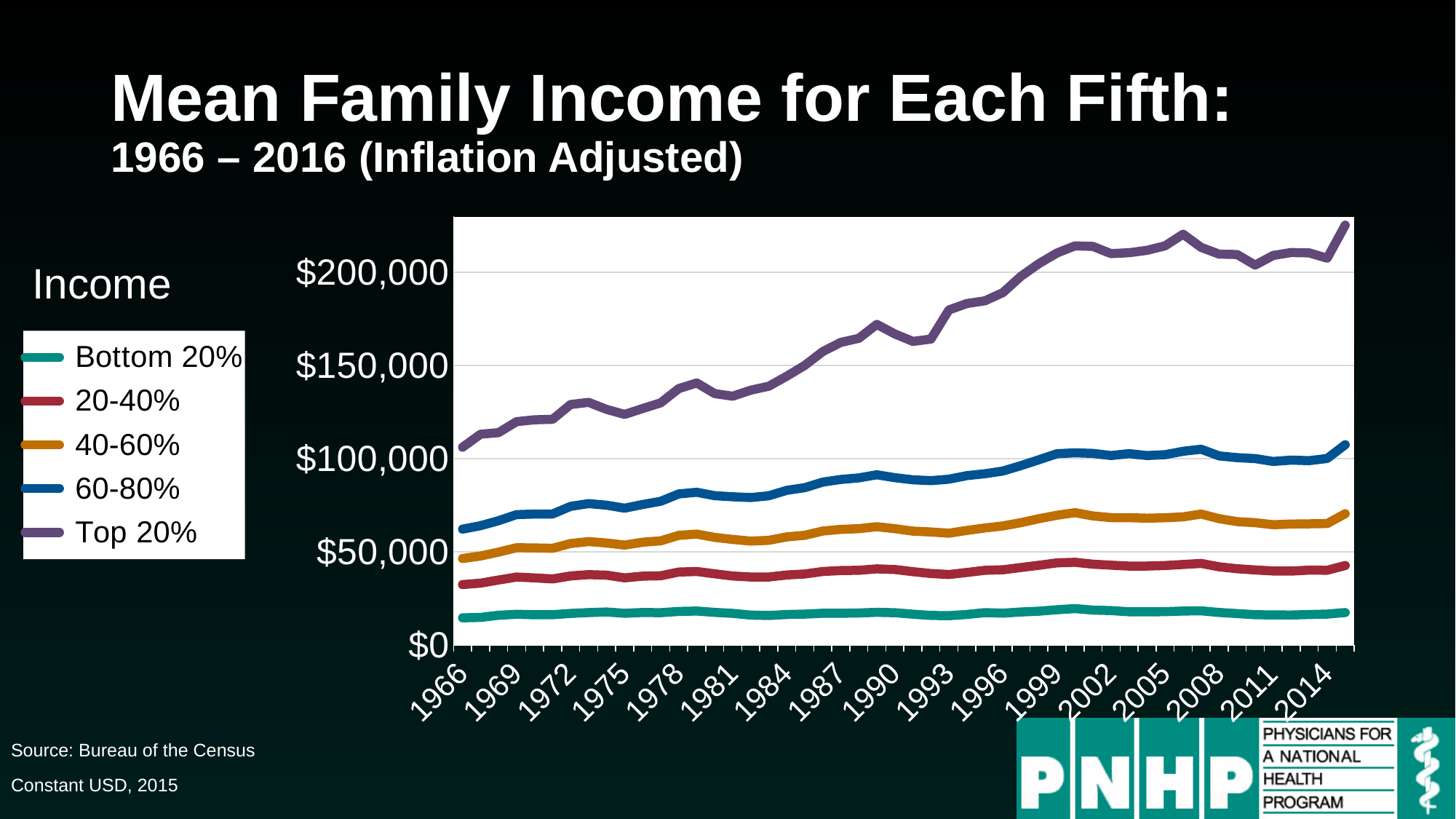
Is the value for the Top 20% in 1966 greater or less than $100,000? greater What kind of chart is shown on the slide? Line chart What is the title of the legend on the slide? Income Which income group has the highest mean family income across the whole period? Top 20% Does the mean family income of the Top 20% generally rise or fall from 1966 to 2016? Rise Is the value for the 20-40% group in 1966 greater or less than $50,000? less Is the value for the Top 20% in 2016 greater or less than $200,000? greater Which is larger in 2016: the mean family income of the Top 20% or of the 60-80% group? Top 20% How many series does the legend list? 5 Which income group has the lowest mean family income across the whole period? Bottom 20%